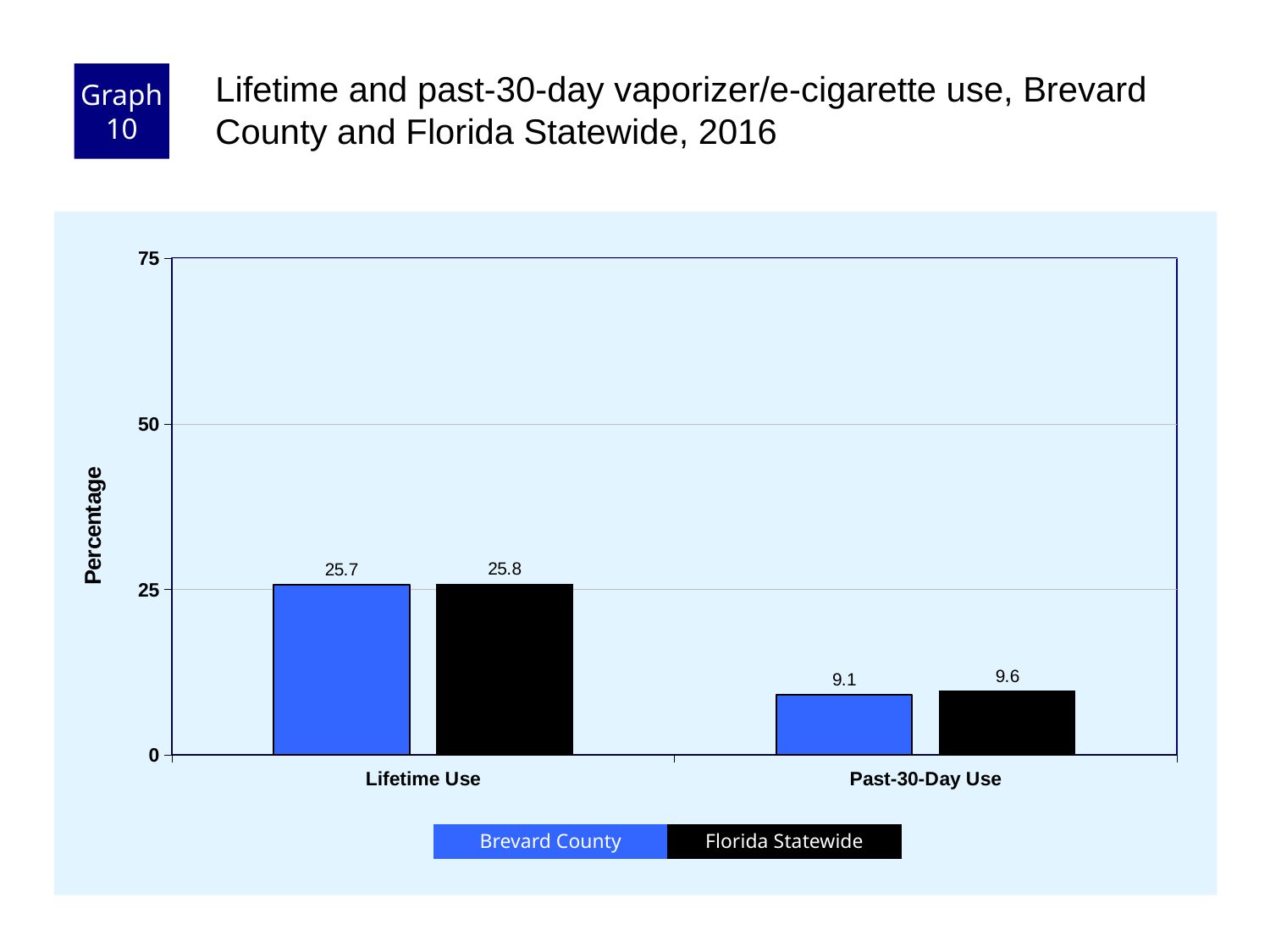
What is the difference between the Brevard County values for Lifetime Use and Past-30-Day Use? 16.6 How many series does the legend list? 2 How many categories are shown on the x axis? 2 Which category has the highest Brevard County value? Lifetime Use What is the difference between the Florida Statewide and Brevard County values for Past-30-Day Use? 0.5 Which category has the lowest Florida Statewide value? Past-30-Day Use What is the Brevard County value for Past-30-Day Use? 9.1 Is the Brevard County value for Lifetime Use greater or less than 50? less What is the Florida Statewide value for Lifetime Use? 25.8 What kind of chart is shown on the slide? bar chart What is the Brevard County value for Lifetime Use? 25.7 What is the Florida Statewide value for Past-30-Day Use? 9.6